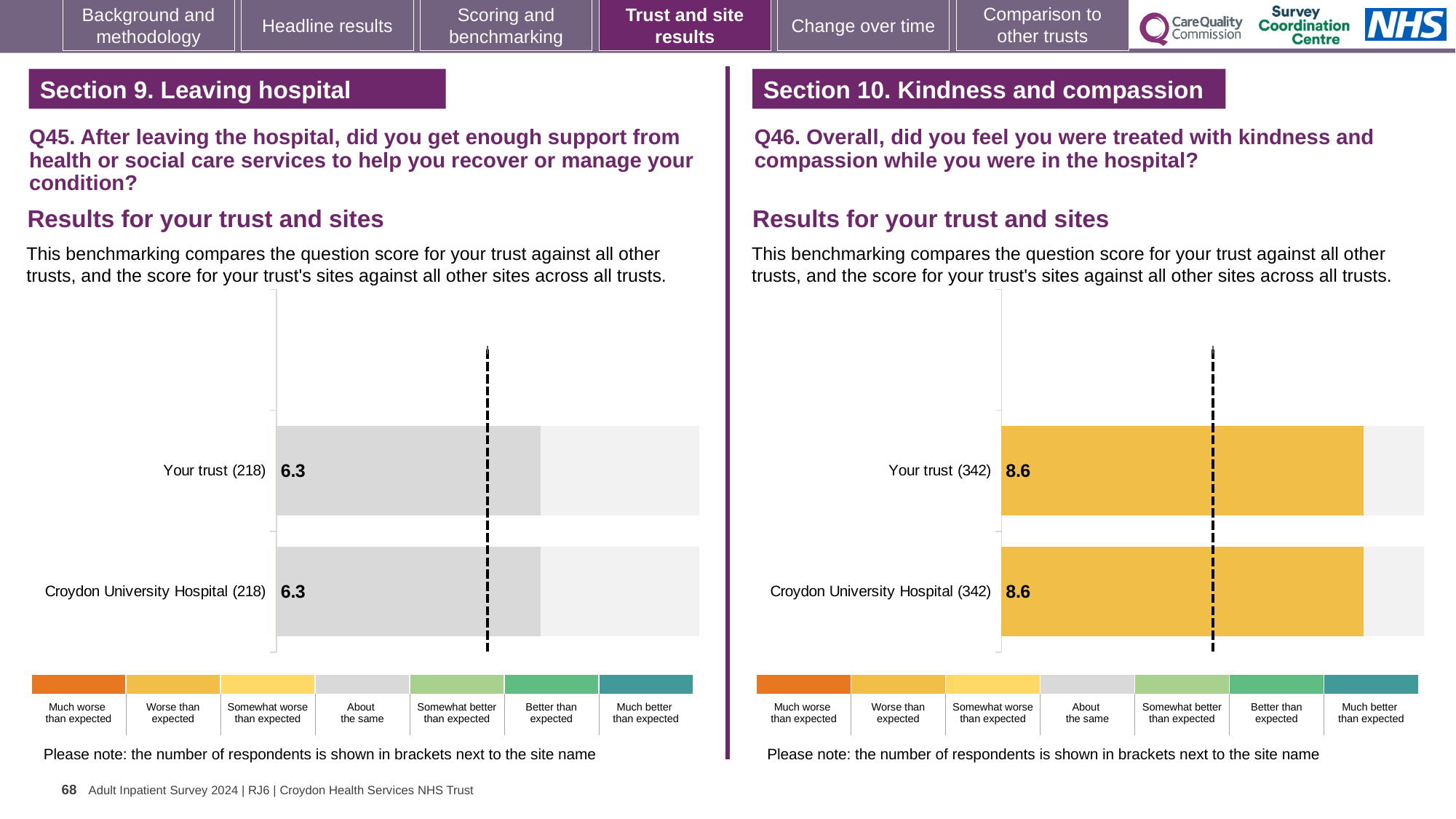
On the Q45 chart (left), what is the score for Croydon University Hospital? 6.3 On the Q45 chart (left), how many bars are plotted? 2 On the Q45 chart (left), what is the difference between the score for Your trust and the score for Croydon University Hospital? 0.0 On the Q46 chart (right), what is the score for Your trust? 8.6 On the Q46 chart (right), how many respondents are shown in brackets for Croydon University Hospital? 342 On the Q46 chart (right), what is the score for Croydon University Hospital? 8.6 On the Q46 chart (right), how many bars are plotted? 2 What kind of chart is used on the Q45 chart (left)? Bar chart On the Q45 chart (left), what is the score for Your trust? 6.3 On the Q46 chart (right), what is the difference between the score for Your trust and the score for Croydon University Hospital? 0.0 On the Q46 chart (right), which benchmark category does the colour of the bars correspond to according to the legend? Worse than expected On the Q45 chart (left), how many respondents are shown in brackets for Your trust? 218